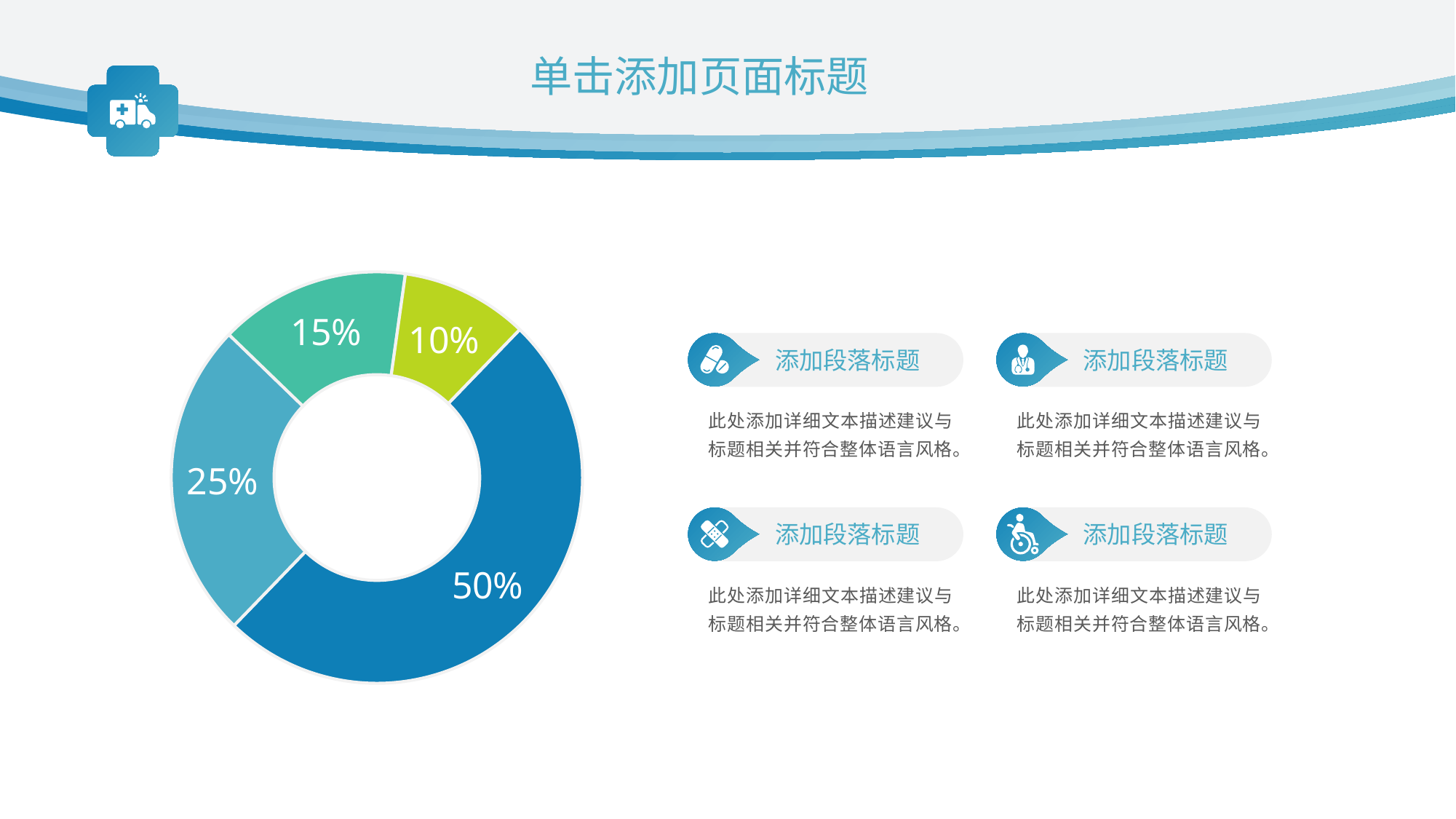
What is the value shown on the largest slice of the doughnut chart? 50% How many slices does the doughnut chart have? 4 What is the value shown on the smallest slice of the doughnut chart? 10% What percentage is shown on the light blue slice of the doughnut chart? 25% What kind of chart is shown on the slide? doughnut chart Does the doughnut chart display a legend? No What percentage is shown on the teal green slice of the doughnut chart? 15% What percentage is shown on the lime green slice of the doughnut chart? 10% What is the difference between the dark blue slice and the light blue slice in the doughnut chart? 25% What percentage is shown on the dark blue slice of the doughnut chart? 50% Which slice is larger in the doughnut chart, the teal green slice or the lime green slice? the teal green slice What is the total of all the slice values shown in the doughnut chart? 100%